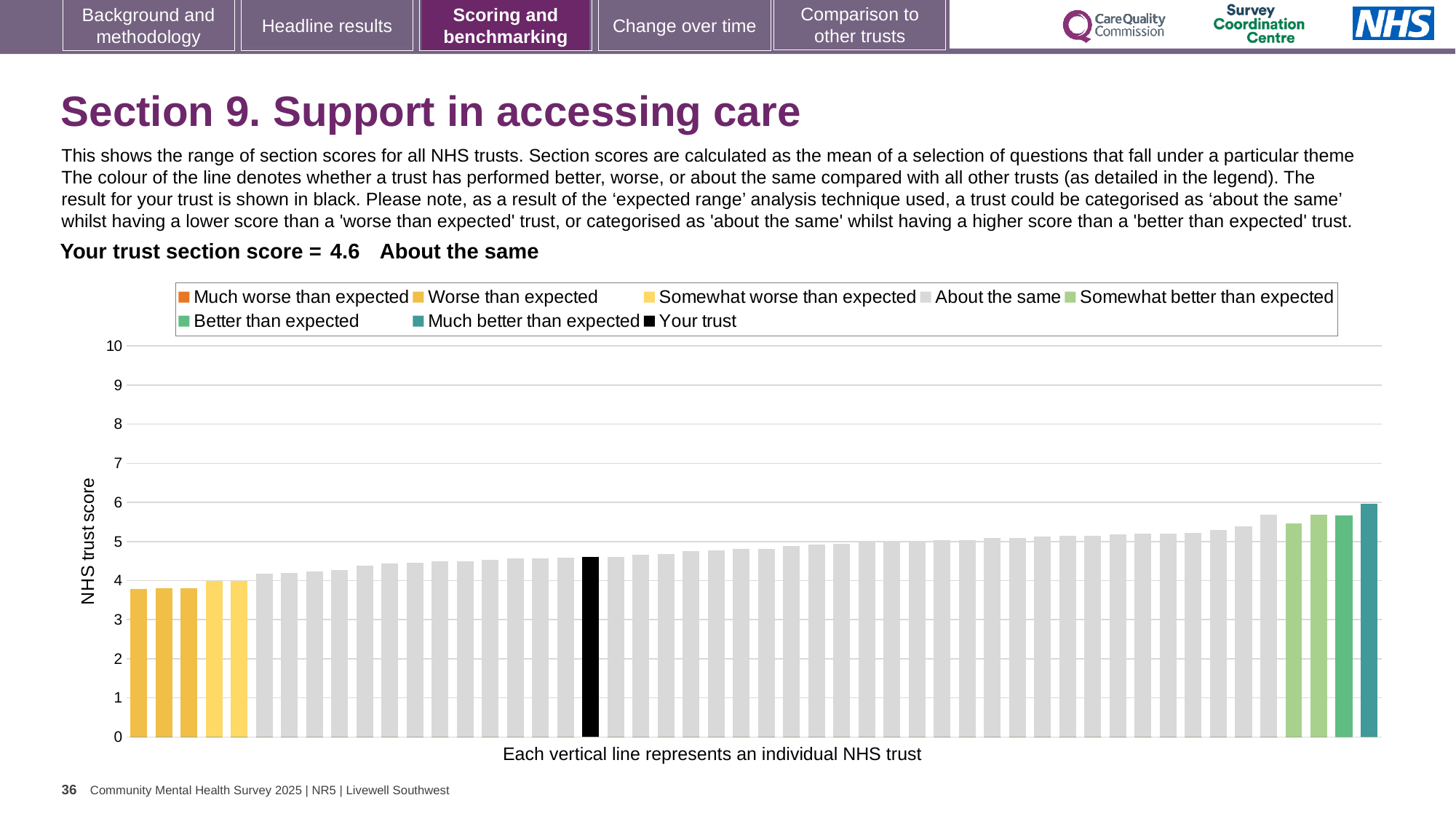
Is the value of the tallest bar in the chart greater or less than 5? greater Is the value of the black 'Your trust' bar greater or less than 5? less What is the title of the vertical axis? NHS trust score Is the value of the tallest bar in the chart greater or less than 7? less What performance category is given for the trust's section score? About the same What kind of chart is shown on the slide? bar chart How many entries does the chart legend list? 8 Do the bar values rise or fall from left to right across the chart? rise What colour is the bar representing 'Your trust'? black What is the trust's section score for Section 9, Support in accessing care? 4.6